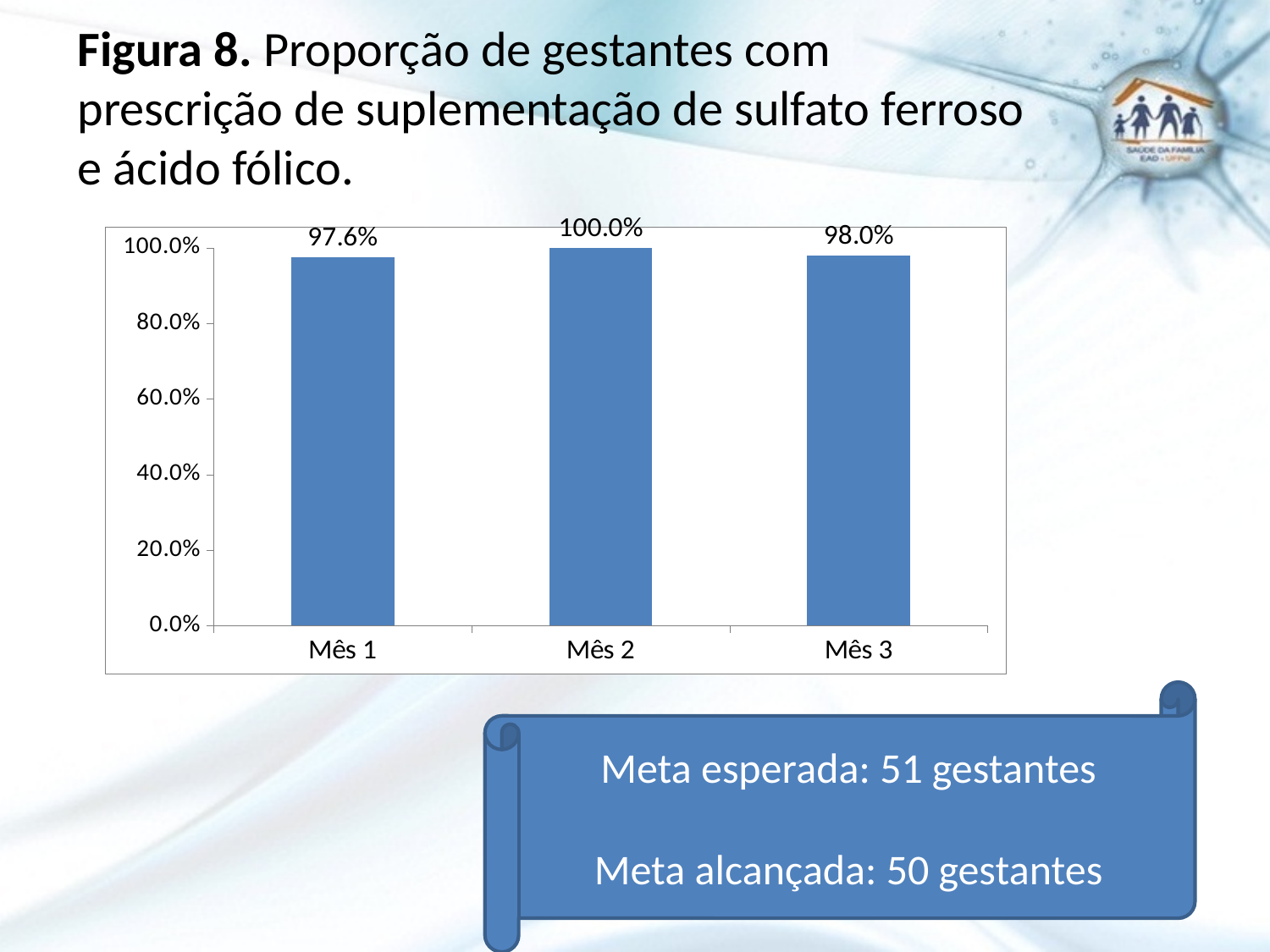
What is the value for Mês 1? 97.6% Which is larger, the value for Mês 2 or the value for Mês 3? Mês 2 What is the difference between the values for Mês 2 and Mês 1? 2.4% What is the value for Mês 2? 100.0% Is the value for Mês 1 greater or less than 80.0%? greater What is the value for Mês 3? 98.0% How many categories are shown on the x axis? 3 What kind of chart is shown on the slide? bar chart What is the difference between the values for Mês 3 and Mês 1? 0.4% Which month has the highest value? Mês 2 Which month has the lowest value? Mês 1 What is the figure number given in the slide title? Figura 8